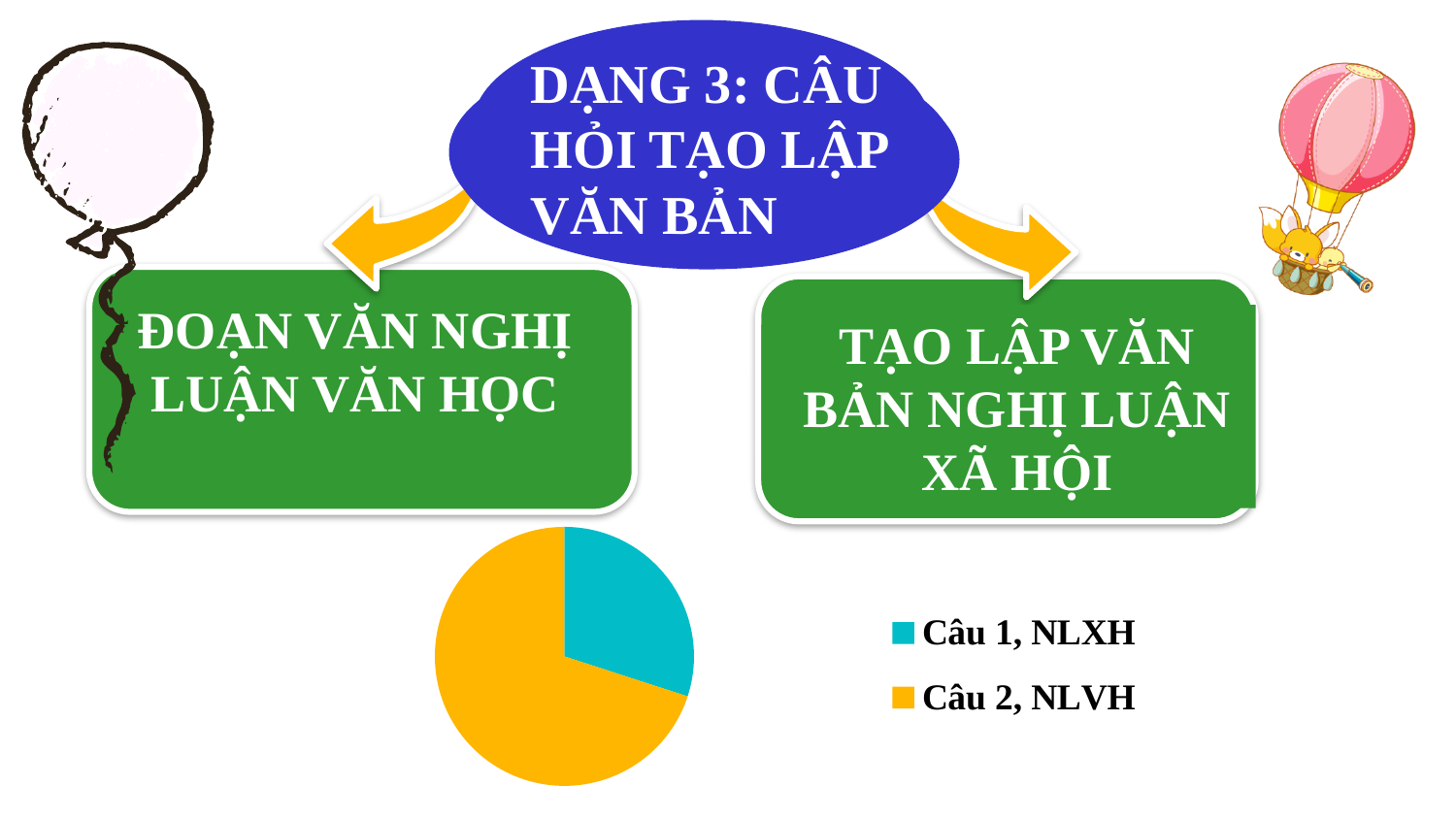
What colour is the slice for Câu 2, NLVH in the pie chart? orange Which slice is larger in the pie chart, Câu 1, NLXH or Câu 2, NLVH? Câu 2, NLVH What kind of chart is shown on the slide? pie chart What colour is the slice for Câu 1, NLXH in the pie chart? teal Does the slice for Câu 2, NLVH take up more or less than half of the pie chart? more How many entries does the legend of the pie chart list? 2 How many slices does the pie chart have? 2 Which slice of the pie chart is the smallest? Câu 1, NLXH Which slice of the pie chart is the largest? Câu 2, NLVH